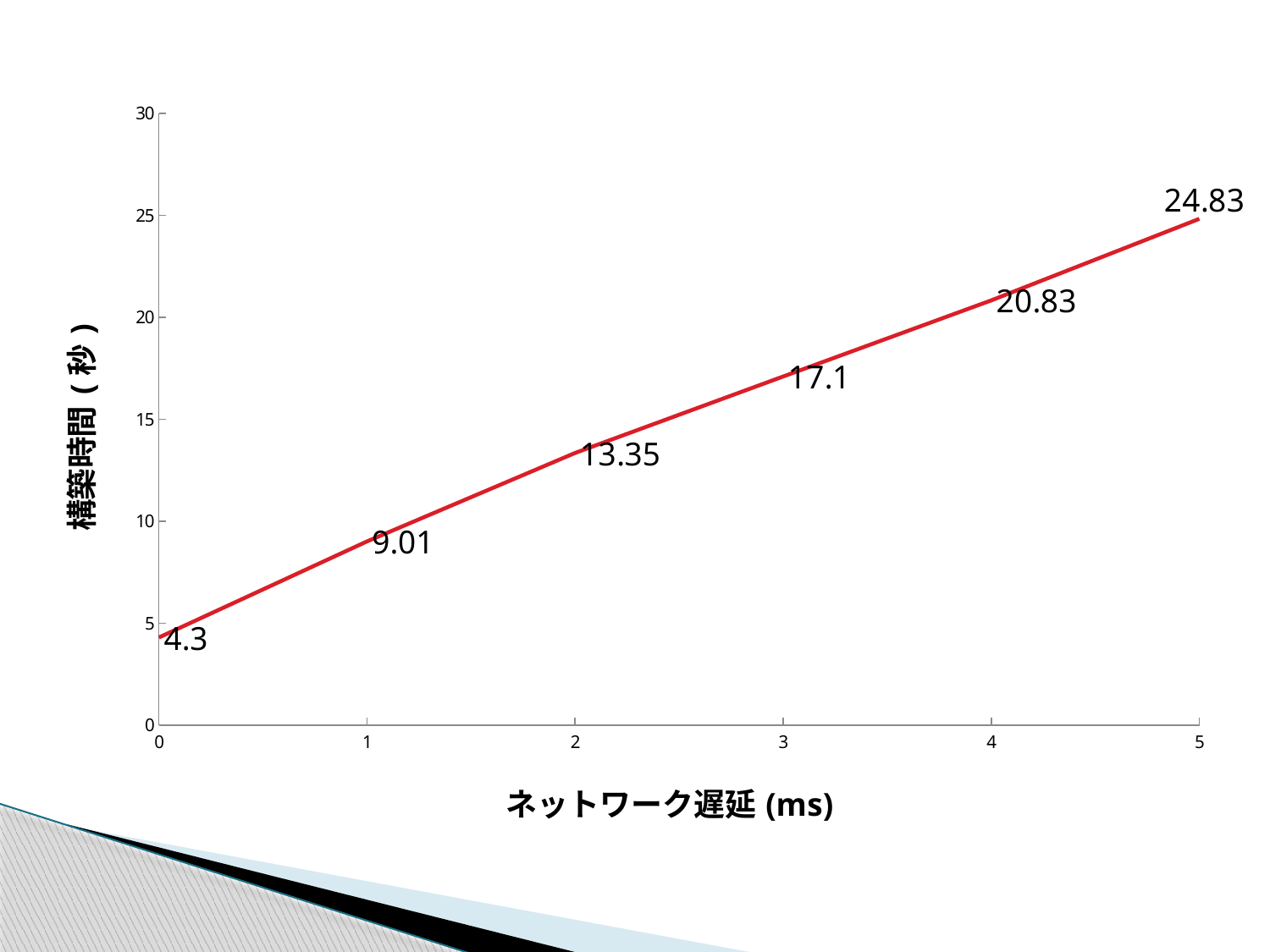
What is the difference in 構築時間 between ネットワーク遅延 of 5 ms and 0 ms? 20.53 What is the 構築時間 when the ネットワーク遅延 is 0 ms? 4.3 What is the 構築時間 when the ネットワーク遅延 is 2 ms? 13.35 At which ネットワーク遅延 value is the 構築時間 highest? 5 At which ネットワーク遅延 value is the 構築時間 lowest? 0 What is the 構築時間 when the ネットワーク遅延 is 4 ms? 20.83 What is the difference in 構築時間 between ネットワーク遅延 of 3 ms and 1 ms? 8.09 What is the 構築時間 when the ネットワーク遅延 is 5 ms? 24.83 Does the 構築時間 rise or fall as the ネットワーク遅延 increases? rise Which has a larger 構築時間: ネットワーク遅延 of 1 ms or 3 ms? 3 ms How many data points are labelled on the line? 6 What type of chart is shown on the slide? line chart